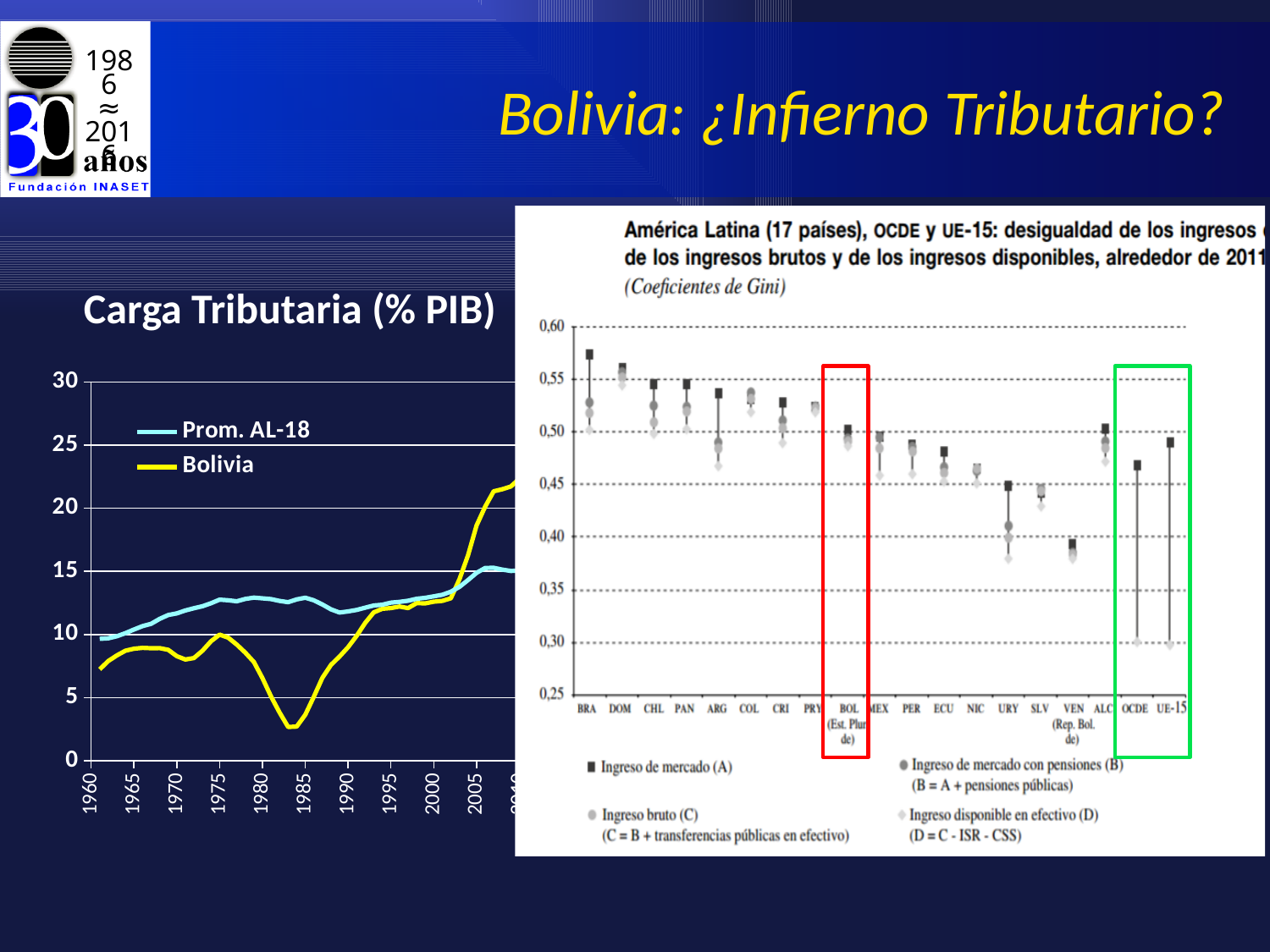
In the 'Carga Tributaria (% PIB)' chart, is the value for Prom. AL-18 in 1975 greater or less than 10? greater In the 'Carga Tributaria (% PIB)' chart, does the Prom. AL-18 series generally rise or fall from 1960 to 2010? rise In the 'Carga Tributaria (% PIB)' chart, is the value for Bolivia around 2007 greater or less than 15? greater In the Gini coefficient chart on the right, which category has the lowest 'Ingreso de mercado (A)' value? VEN How many categories are shown on the x axis of the Gini coefficient chart on the right? 19 In the Gini coefficient chart on the right, is the 'Ingreso de mercado (A)' value for BRA greater or less than 0.55? greater How many series does the legend of the Gini coefficient chart on the right list? 4 What kind of chart is the 'Carga Tributaria (% PIB)' chart on the left? line chart How many series does the legend of the 'Carga Tributaria (% PIB)' chart list? 2 In the 'Carga Tributaria (% PIB)' chart, which series is higher around 1985, Prom. AL-18 or Bolivia? Prom. AL-18